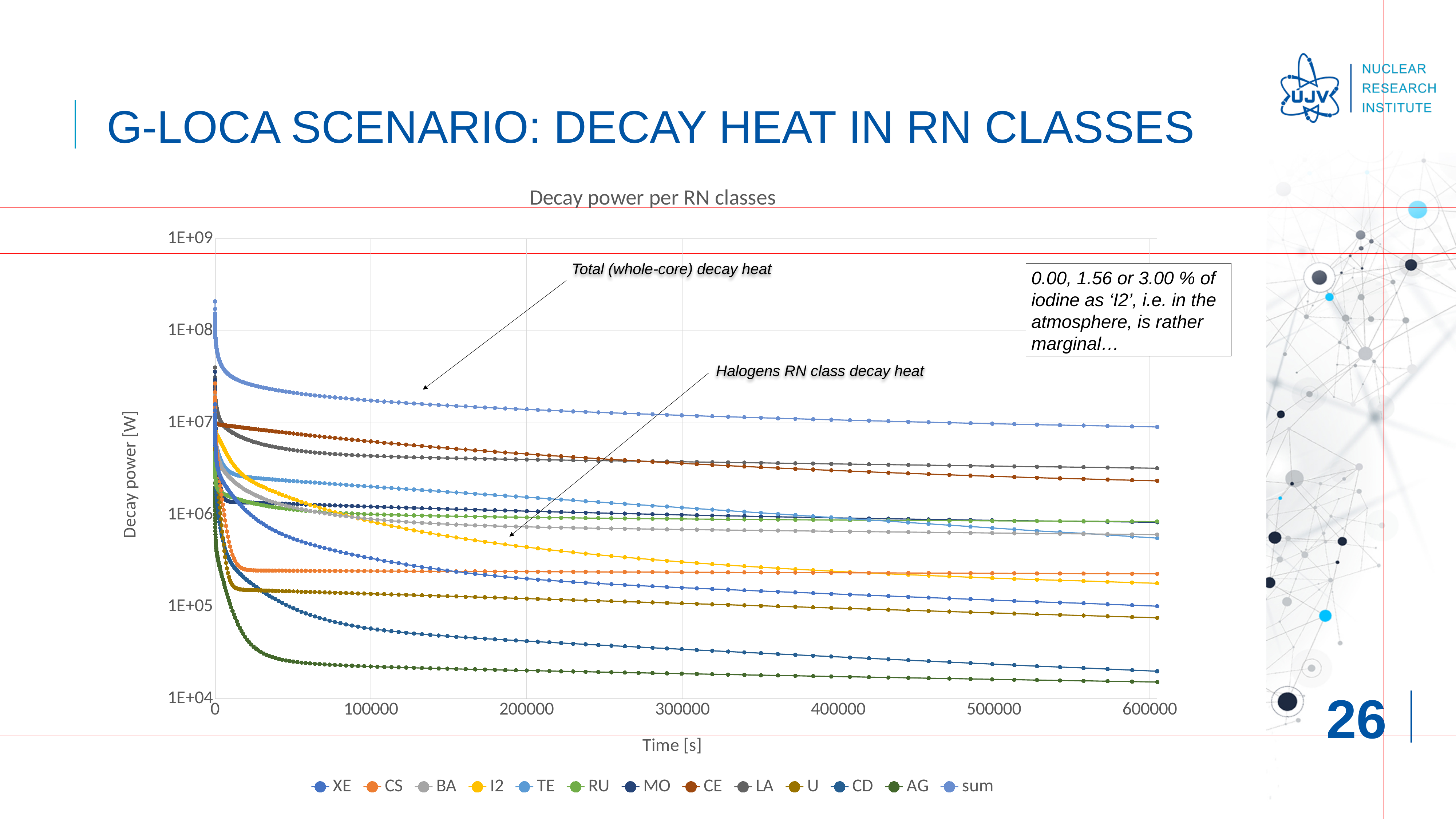
At 600000 s, which series has the larger decay power, LA or CE? LA Do the decay power values rise or fall as time increases along the x axis? Fall Which series has the lowest decay power at 600000 s? AG How many series does the legend of the chart list? 13 Is the value of the I2 series at 600000 s greater or less than 1E+05? greater What is the label of the y axis of the chart? Decay power [W] Is the value of the sum series at 100000 s greater or less than 1E+07? greater What kind of chart is shown on the slide? Line chart Which series has the highest decay power across the whole time range? sum Is the value of the CD series at 600000 s greater or less than 1E+05? less What is the title of the chart? Decay power per RN classes